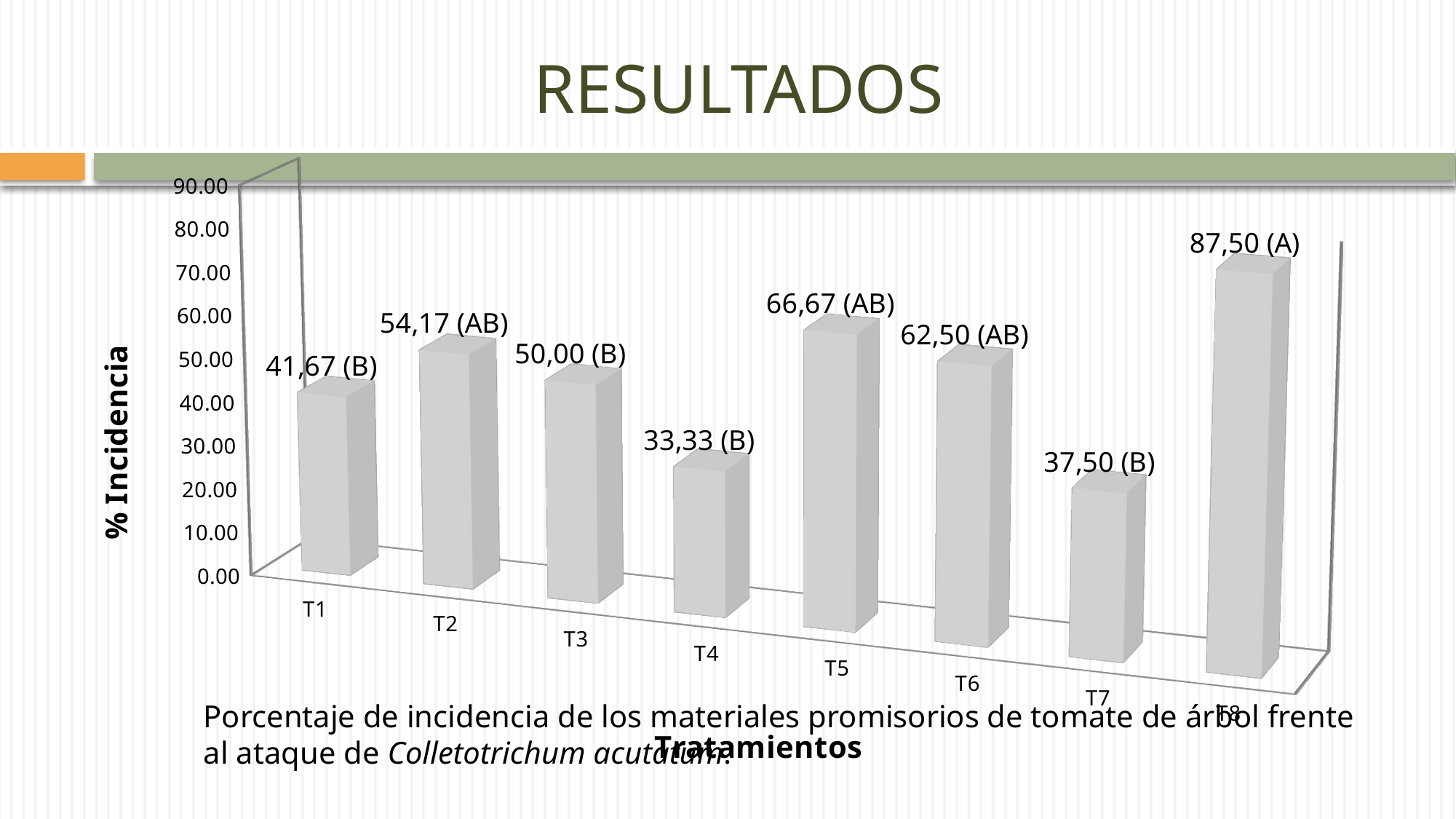
What is the % Incidencia value labelled for treatment T5? 66,67 (AB) What kind of chart is shown on the slide? Bar chart How many treatments are shown on the x axis? 8 Which has a higher % Incidencia, T2 or T3? T2 What is the % Incidencia value labelled for treatment T1? 41,67 (B) Which treatment has the highest % Incidencia? T8 Is the value for T6 greater or less than 50.00? greater What is the % Incidencia value labelled for treatment T7? 37,50 (B) What is the difference in % Incidencia between T5 and T6? 4,17 What is the difference in % Incidencia between T8 and T4? 54,17 Which treatment has the lowest % Incidencia? T4 What is the label of the vertical axis? % Incidencia